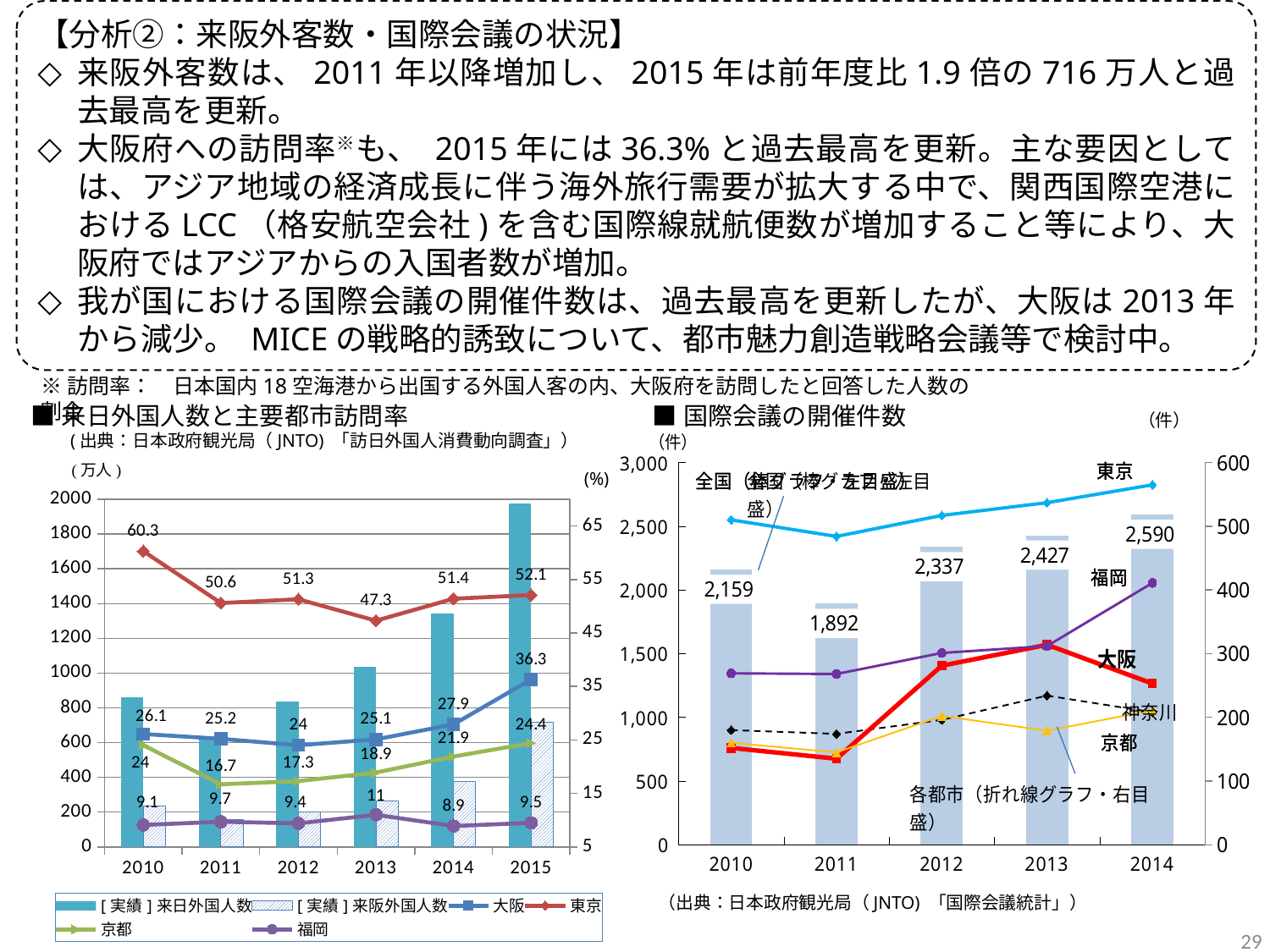
In the left chart (来日外国人数と主要都市訪問率), which is larger in 2014, the 大阪 value or the 京都 value? 大阪 In the left chart (来日外国人数と主要都市訪問率), what is the value for 東京 in 2010? 60.3 In the right chart (国際会議の開催件数), is the 東京 value for 2014 greater or less than 500 on the right axis? greater In the right chart (国際会議の開催件数), what is the 全国 value for 2014? 2,590 In the left chart (来日外国人数と主要都市訪問率), in which year is the 大阪 line highest? 2015 In the right chart (国際会議の開催件数), what is the difference between the 全国 values for 2014 and 2013? 163 In the left chart (来日外国人数と主要都市訪問率), what is the value for 大阪 in 2015? 36.3 In the left chart (来日外国人数と主要都市訪問率), how many series does the legend list? 6 In the right chart (国際会議の開催件数), which year has the lowest 全国 value? 2011 In the left chart (来日外国人数と主要都市訪問率), what is the difference between the 東京 values for 2010 and 2011? 9.7 In the right chart (国際会議の開催件数), how many years are shown on the x axis? 5 In the left chart (来日外国人数と主要都市訪問率), what is the value for 福岡 in 2013? 11